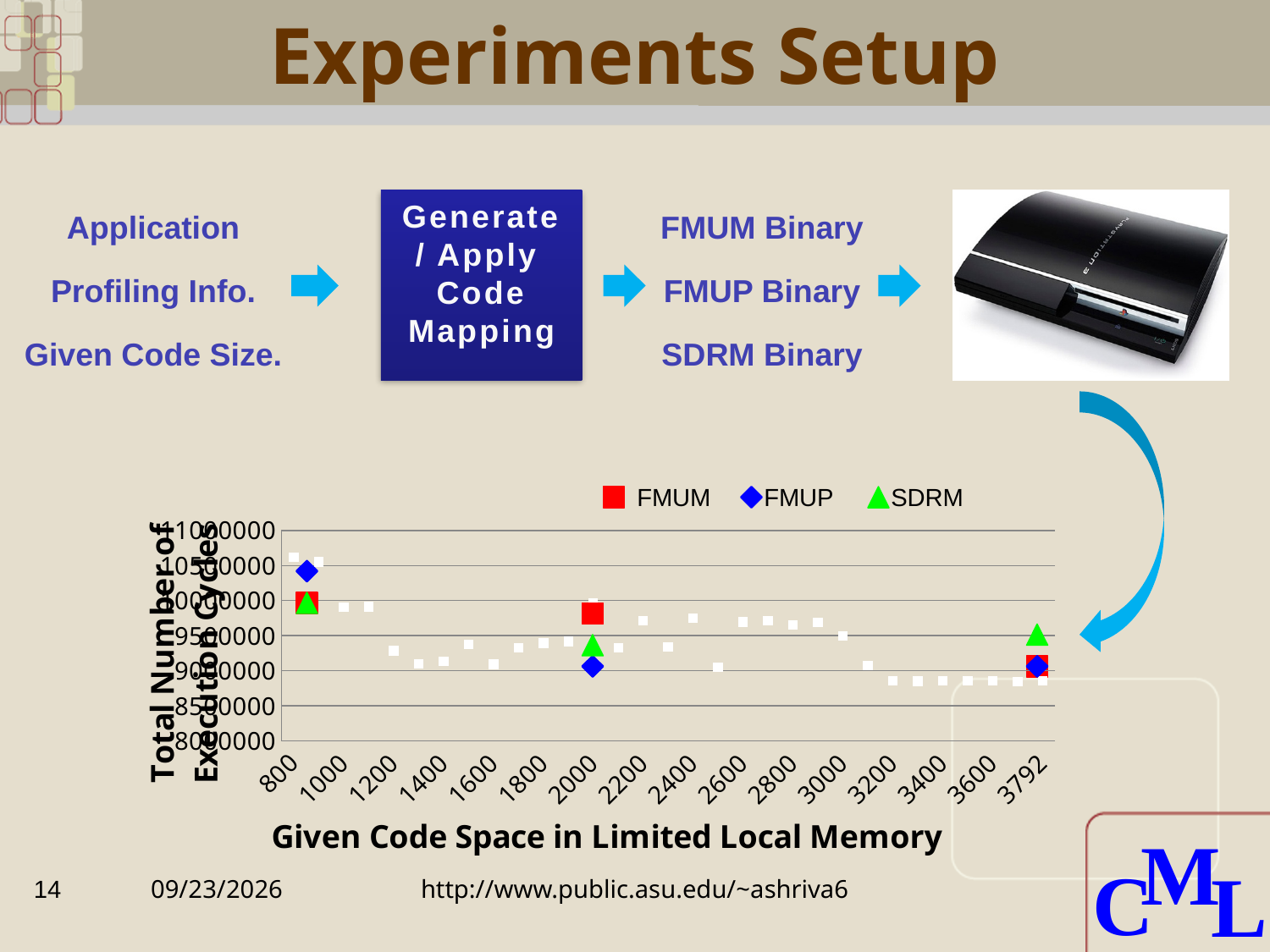
What is the title of the x axis of the chart? Given Code Space in Limited Local Memory At code space 2000, which series has the larger value, SDRM or FMUP? SDRM What kind of chart is shown on the slide? scatter chart Is the FMUM value at code space 3792 greater or less than 9500000? less At code space 3792, which series has the larger value, SDRM or FMUM? SDRM At code space 2000, which series has the larger value, FMUM or FMUP? FMUM Which series in the legend is marked with a green triangle? SDRM Is the FMUM value at code space 2000 greater or less than 10000000? less Do the FMUP values rise or fall overall as the given code space increases? fall How many series does the chart legend list? 3 Is the FMUP value at the smallest code space (near 800) greater or less than 10000000? greater